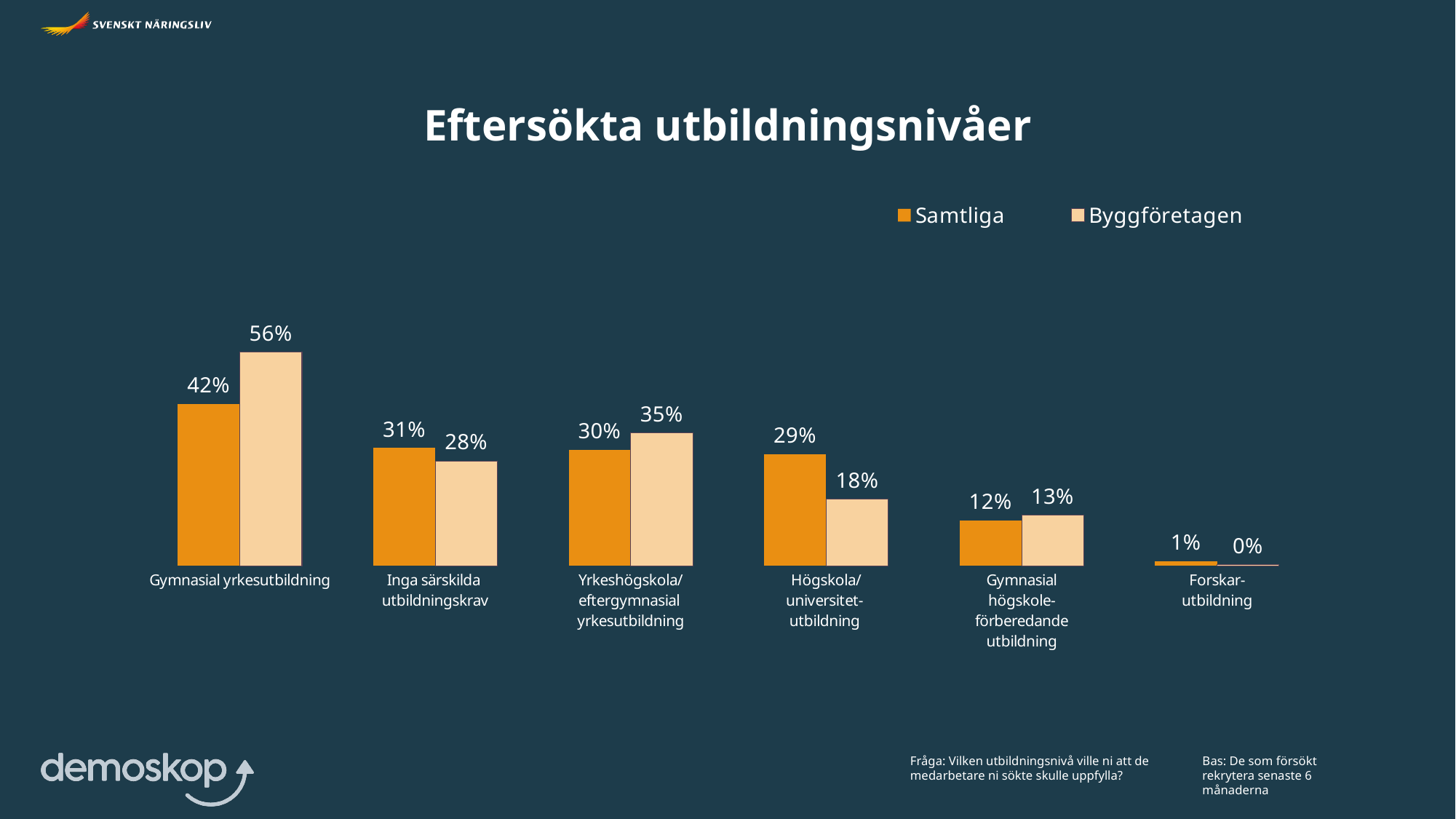
For Yrkeshögskola/eftergymnasial yrkesutbildning, which series has the larger value, Samtliga or Byggföretagen? Byggföretagen What is the difference between Byggföretagen and Samtliga for Gymnasial yrkesutbildning? 14% What is the value for Byggföretagen for Högskola/universitetutbildning? 18% What is the value for Samtliga for Gymnasial yrkesutbildning? 42% What is the value for Byggföretagen for Gymnasial yrkesutbildning? 56% How many categories are shown on the x axis? 6 What is the difference between Samtliga and Byggföretagen for Högskola/universitetutbildning? 11% What kind of chart is shown on the slide? Bar chart Which category has the highest value for Byggföretagen? Gymnasial yrkesutbildning How many series does the legend list? 2 Which category has the lowest value for Samtliga? Forskarutbildning What is the value for Samtliga for Inga särskilda utbildningskrav? 31%